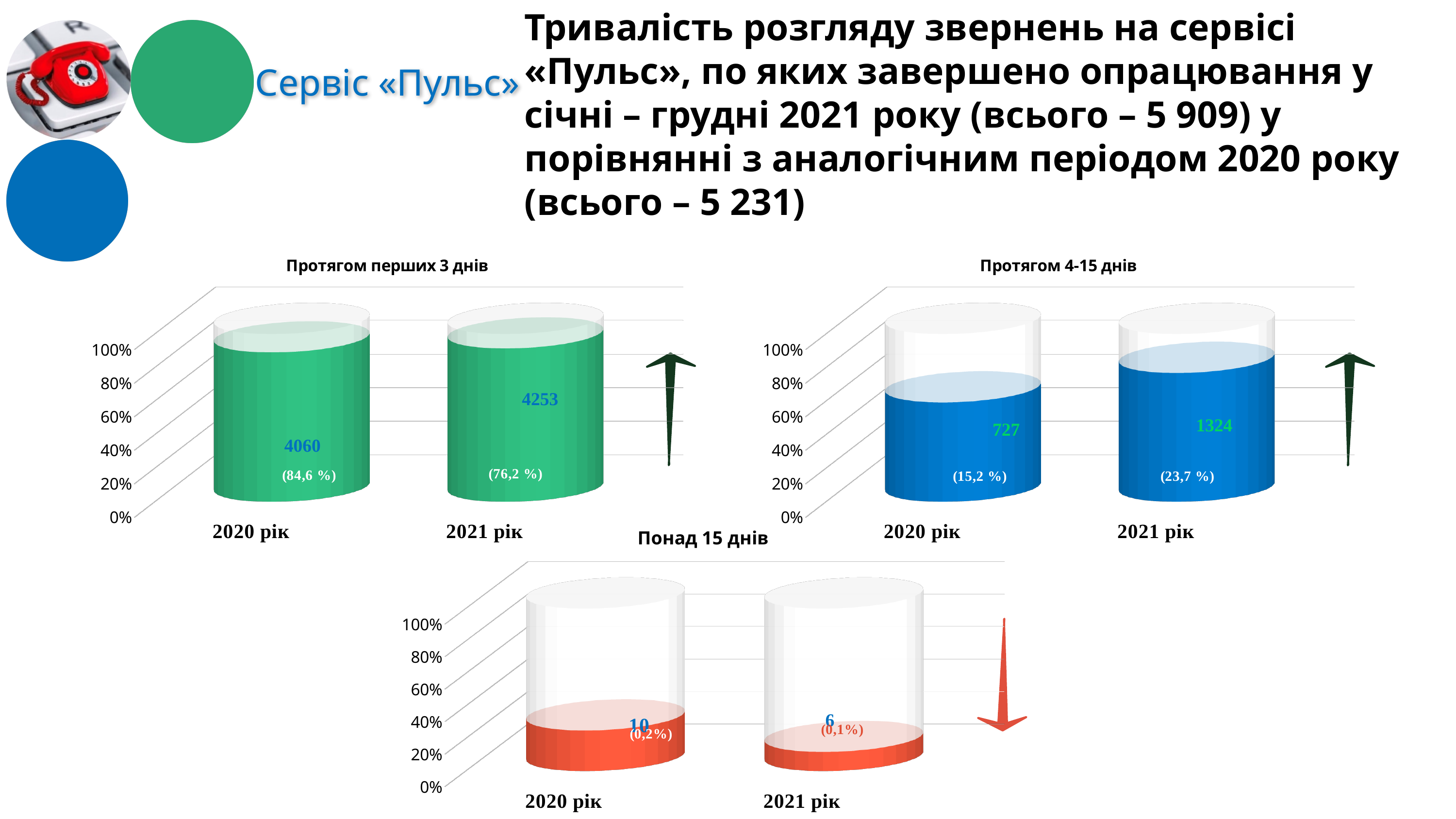
In the chart titled «Протягом 4-15 днів», what is the value for 2021 рік? 1324 In the chart titled «Протягом 4-15 днів», what is the difference between the values for 2021 рік and 2020 рік? 597 In the chart titled «Понад 15 днів», which year has the lower value? 2021 рік In the chart titled «Протягом перших 3 днів», what is the value for 2020 рік? 4060 In the chart titled «Протягом перших 3 днів», how many categories are shown on the x axis? 2 In the chart titled «Понад 15 днів», what is the value for 2020 рік? 10 In the chart titled «Протягом перших 3 днів», what is the difference between the values for 2021 рік and 2020 рік? 193 In the chart titled «Протягом 4-15 днів», which year has the higher value? 2021 рік How many charts are shown on the slide? 3 In the chart titled «Понад 15 днів», what percentage is shown for 2021 рік? 0,1% In the chart titled «Протягом перших 3 днів», what percentage is shown for 2021 рік? 76,2 % In the chart titled «Протягом 4-15 днів», what percentage is shown for 2020 рік? 15,2 %